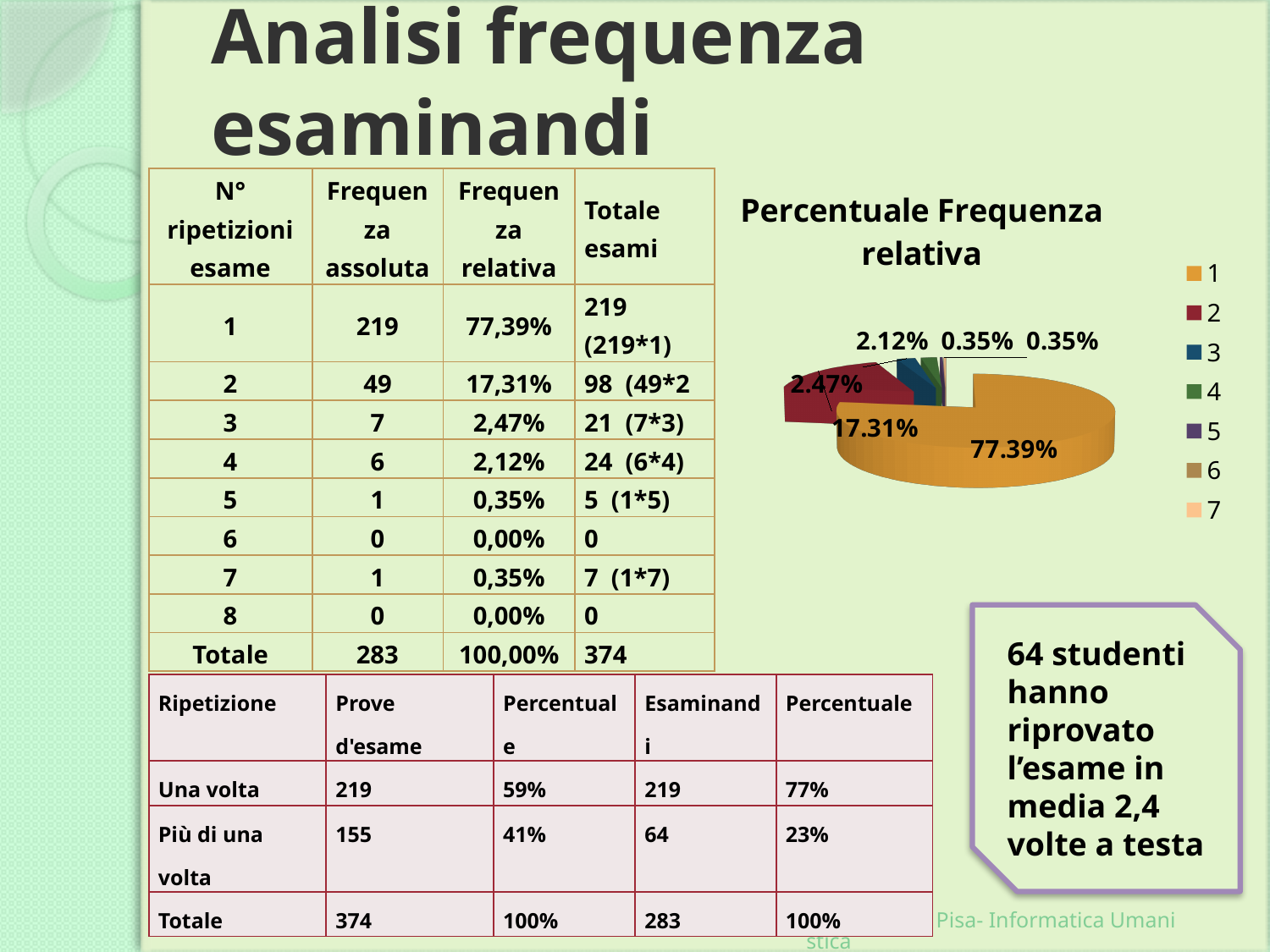
What is the difference between the percentages shown for category 1 and category 2 in the pie chart? 60.08% In the pie chart, what percentage is shown for category 4? 2.12% In the pie chart, what percentage is shown for the largest slice (category 1)? 77.39% How many entries does the chart's legend list? 7 In the pie chart, what percentage is shown for category 2? 17.31% What is the title of the chart on the slide? Percentuale Frequenza relativa In the pie chart, which slice is larger: category 2 or category 3? category 2 What kind of chart is shown on the slide? pie chart In the pie chart, what percentage is shown for category 3? 2.47% What is the combined share of the two largest slices (categories 1 and 2) in the pie chart? 94.70% Which legend category has the largest slice in the pie chart? 1 What colour is the largest slice of the pie chart? orange